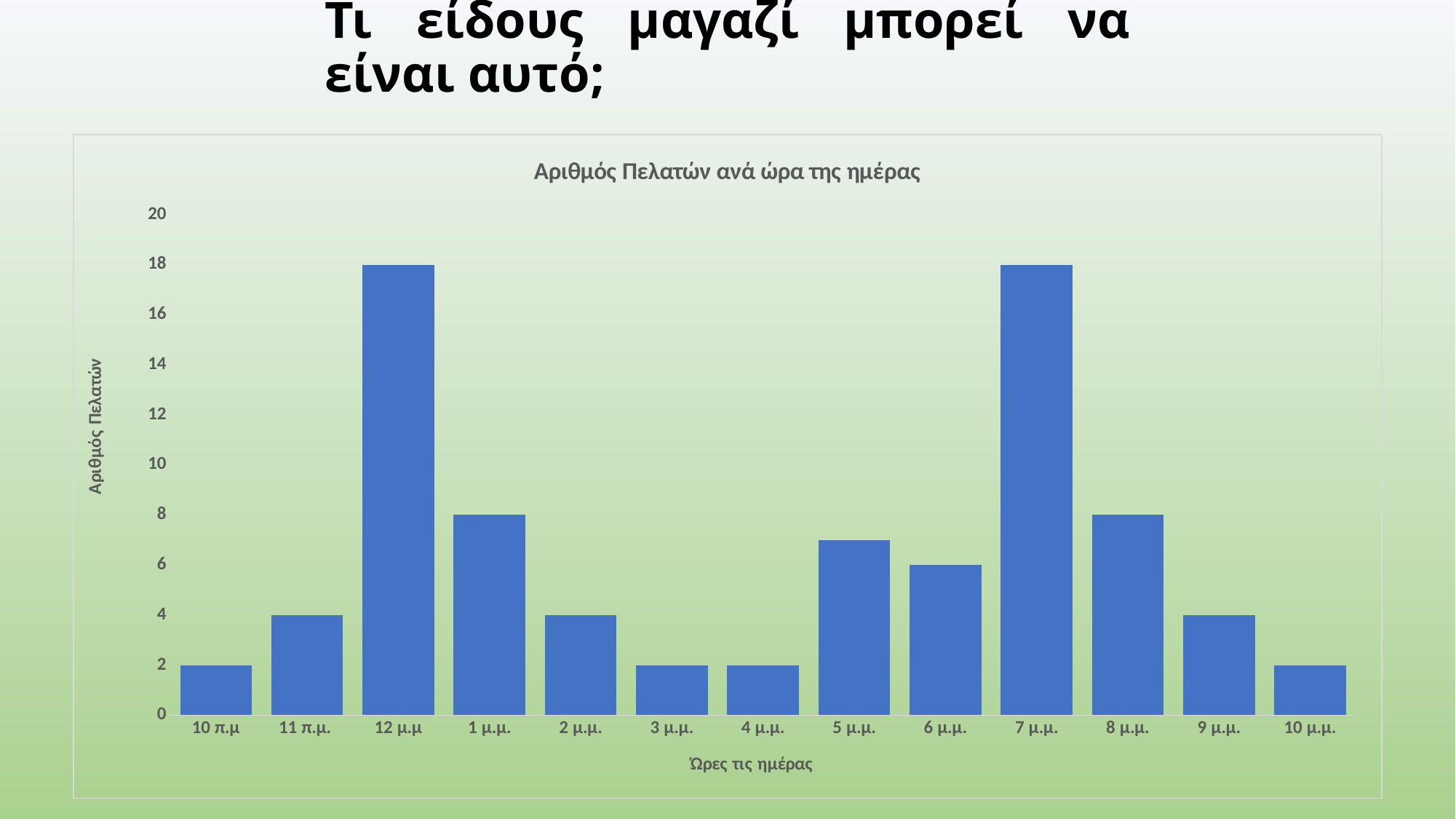
How many hour categories are shown on the x axis? 13 What is the number of customers at 12 μ.μ? 18 What is the number of customers at 6 μ.μ.? 6 Is the value for 5 μ.μ. greater or less than 6? greater What is the highest number of customers reached in any hour? 18 What is the number of customers at 1 μ.μ.? 8 Do the values rise or fall from 12 μ.μ to 3 μ.μ.? fall What kind of chart is shown on the slide? bar chart What is the title of the chart? Αριθμός Πελατών ανά ώρα της ημέρας What is the difference in customers between 7 μ.μ. and 8 μ.μ.? 10 What is the number of customers at 10 π.μ? 2 Which has more customers, 12 μ.μ or 1 μ.μ.? 12 μ.μ